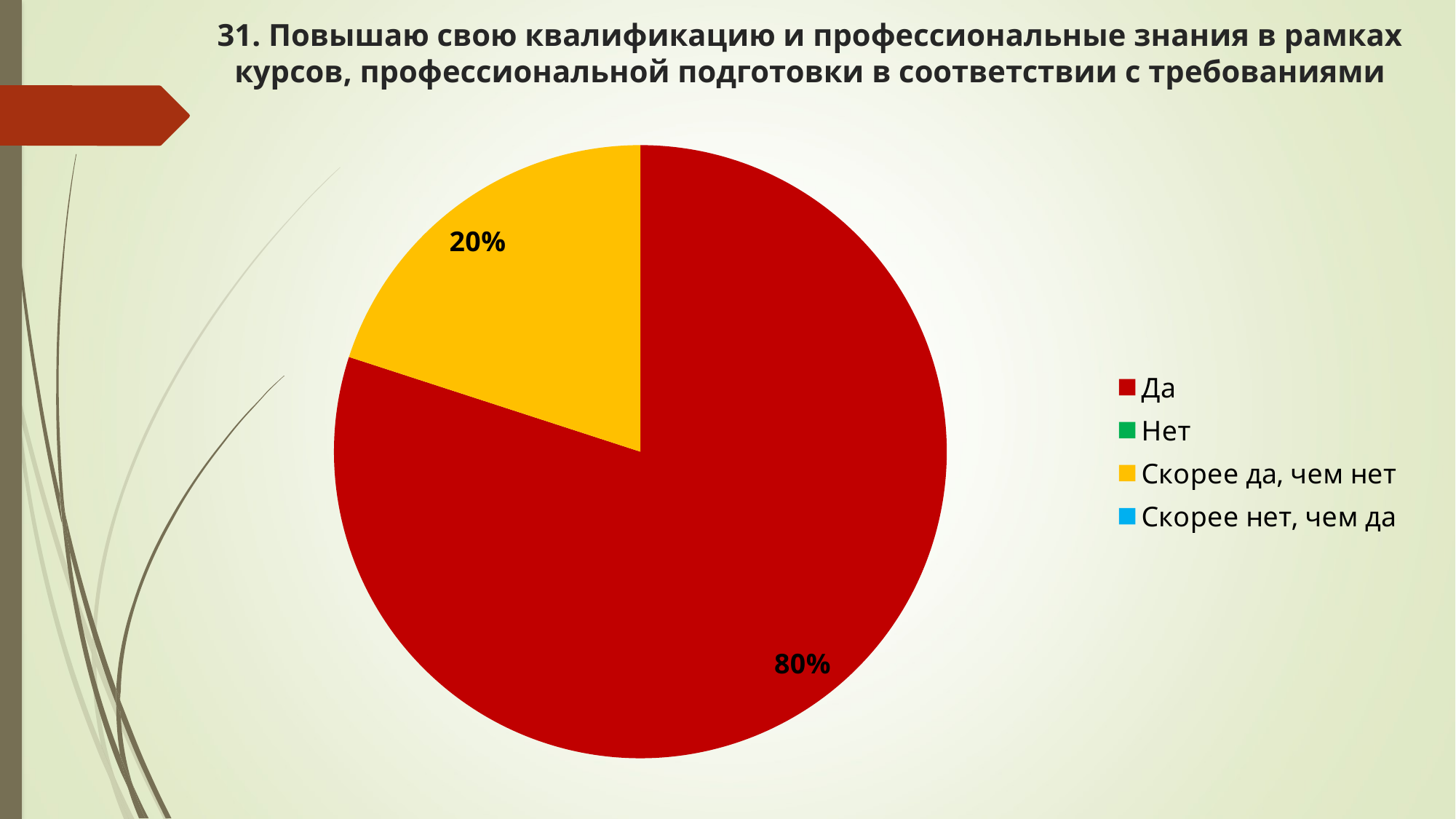
How many entries does the legend list? 4 How many slices are visible in the pie? 2 Is the value for "Да" greater or less than 50%? greater What share of the pie does "Да" take? 80% Which is larger, the slice for "Да" or the slice for "Скорее да, чем нет"? Да Which legend entry is shown in red? Да What kind of chart is shown on the slide? pie chart Which category has the largest slice of the pie? Да What share of the pie does "Скорее да, чем нет" take? 20% What is the difference in percentage points between the "Да" slice and the "Скорее да, чем нет" slice? 60% What colour is the slice for "Скорее да, чем нет"? yellow